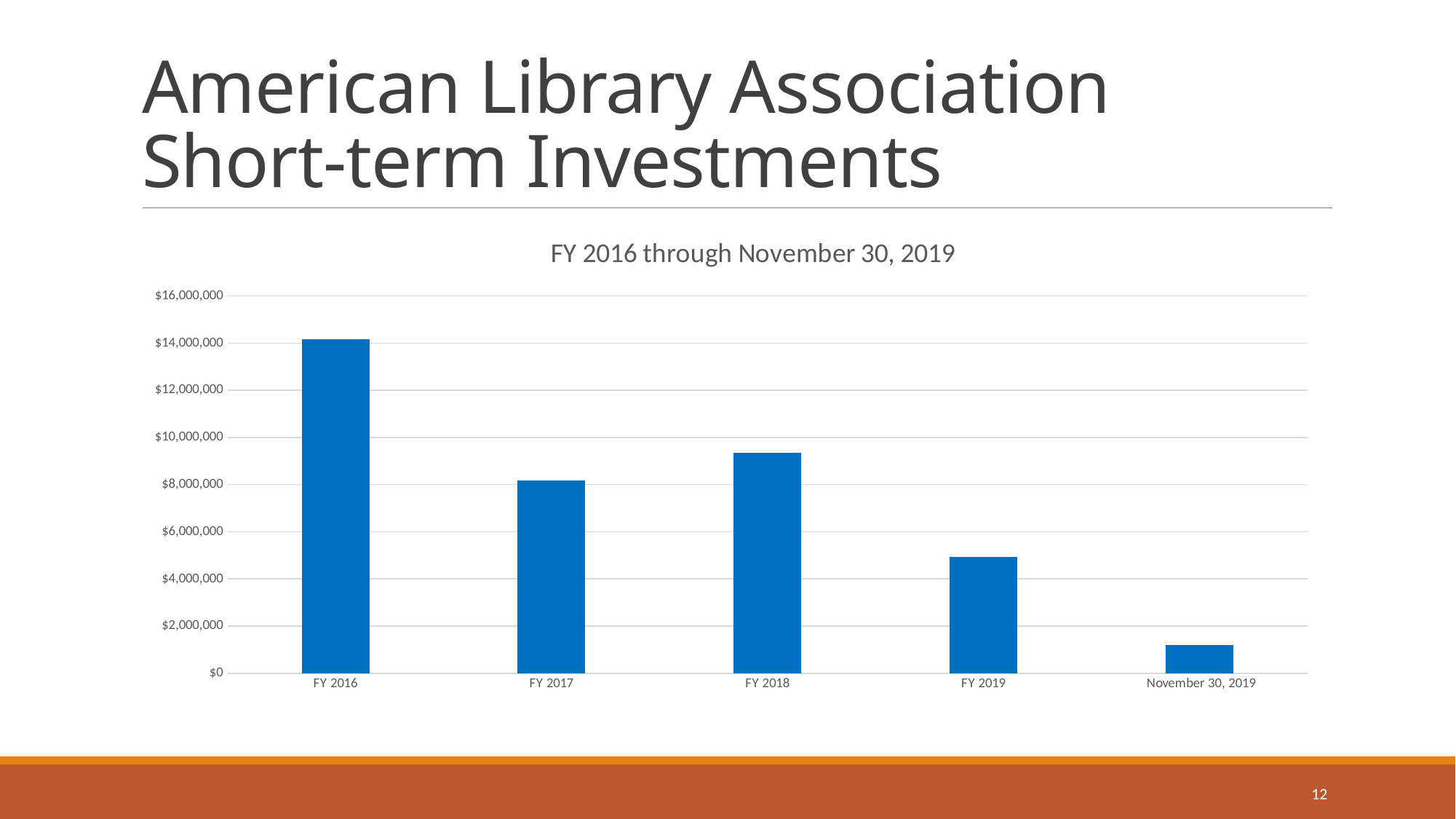
Which is larger, the value for FY 2019 or the value for November 30, 2019? FY 2019 Is the value for FY 2018 greater or less than $10,000,000? less Is the value for FY 2016 greater or less than $12,000,000? greater Is the value for FY 2019 greater or less than $4,000,000? greater What is the title of the chart? FY 2016 through November 30, 2019 What kind of chart is shown on the slide? bar chart Which category has the highest short-term investment value? FY 2016 Which category has the lowest short-term investment value? November 30, 2019 Which is larger, the value for FY 2017 or the value for FY 2018? FY 2018 How many bars (categories) are plotted in the chart? 5